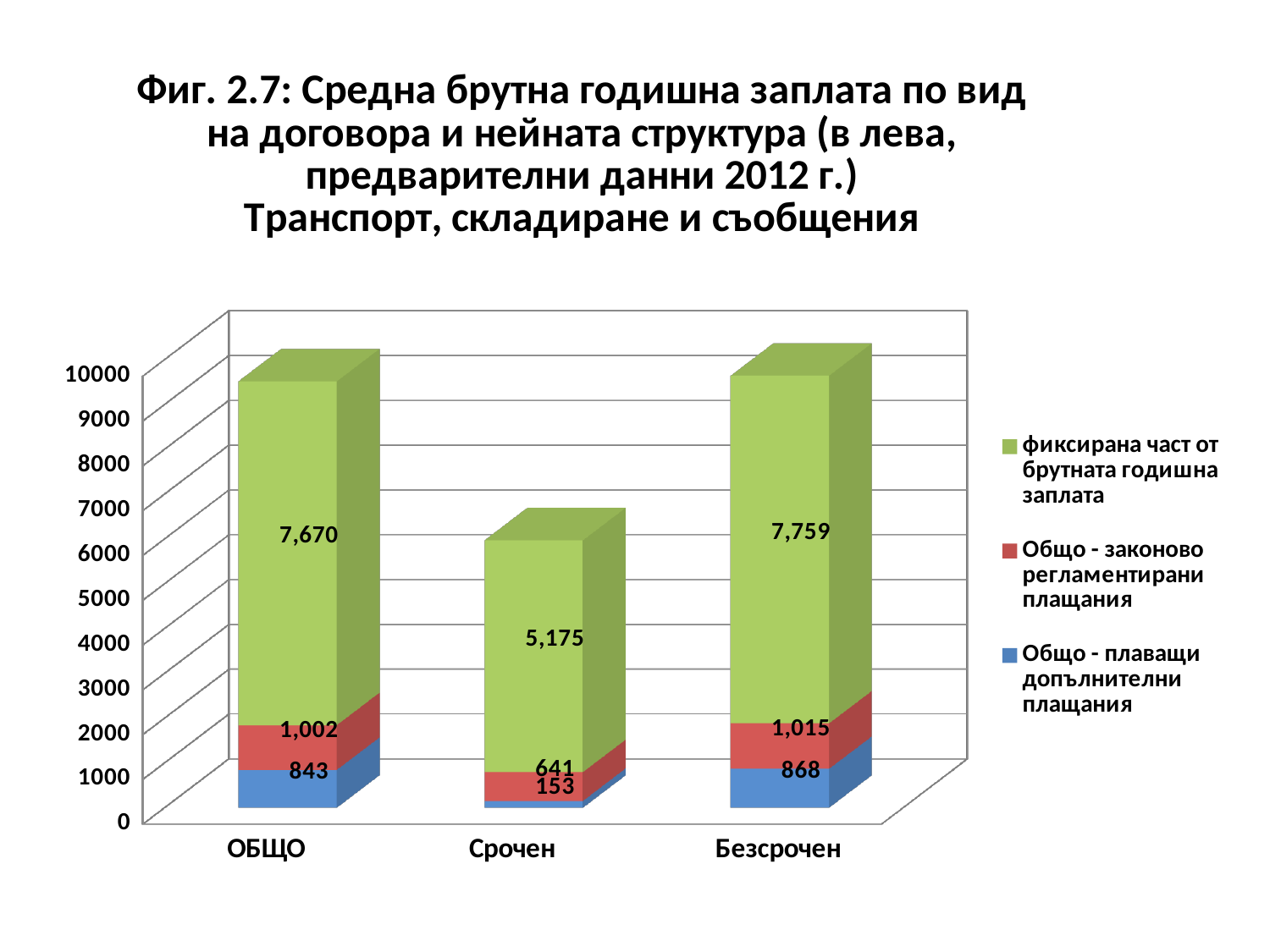
What is the total of the stacked bar for ОБЩО? 9,515 What is the value of Общо - плаващи допълнителни плащания for Безсрочен? 868 What is the value of Общо - законово регламентирани плащания for ОБЩО? 1,002 Which category has the lowest value for Общо - плаващи допълнителни плащания? Срочен What is the value of the fixed part of gross annual salary (фиксирана част от брутната годишна заплата) for Срочен? 5,175 How many categories are shown on the x axis? 3 What kind of chart is shown on the slide? Stacked bar chart What is the total of the stacked bar for Срочен? 5,969 Which is larger: Общо - законово регламентирани плащания for Безсрочен or for ОБЩО? Безсрочен What is the difference between the fixed part (фиксирана част) values for Безсрочен and Срочен? 2,584 How many series does the legend list? 3 Which category has the highest value for the fixed part of gross annual salary (фиксирана част)? Безсрочен